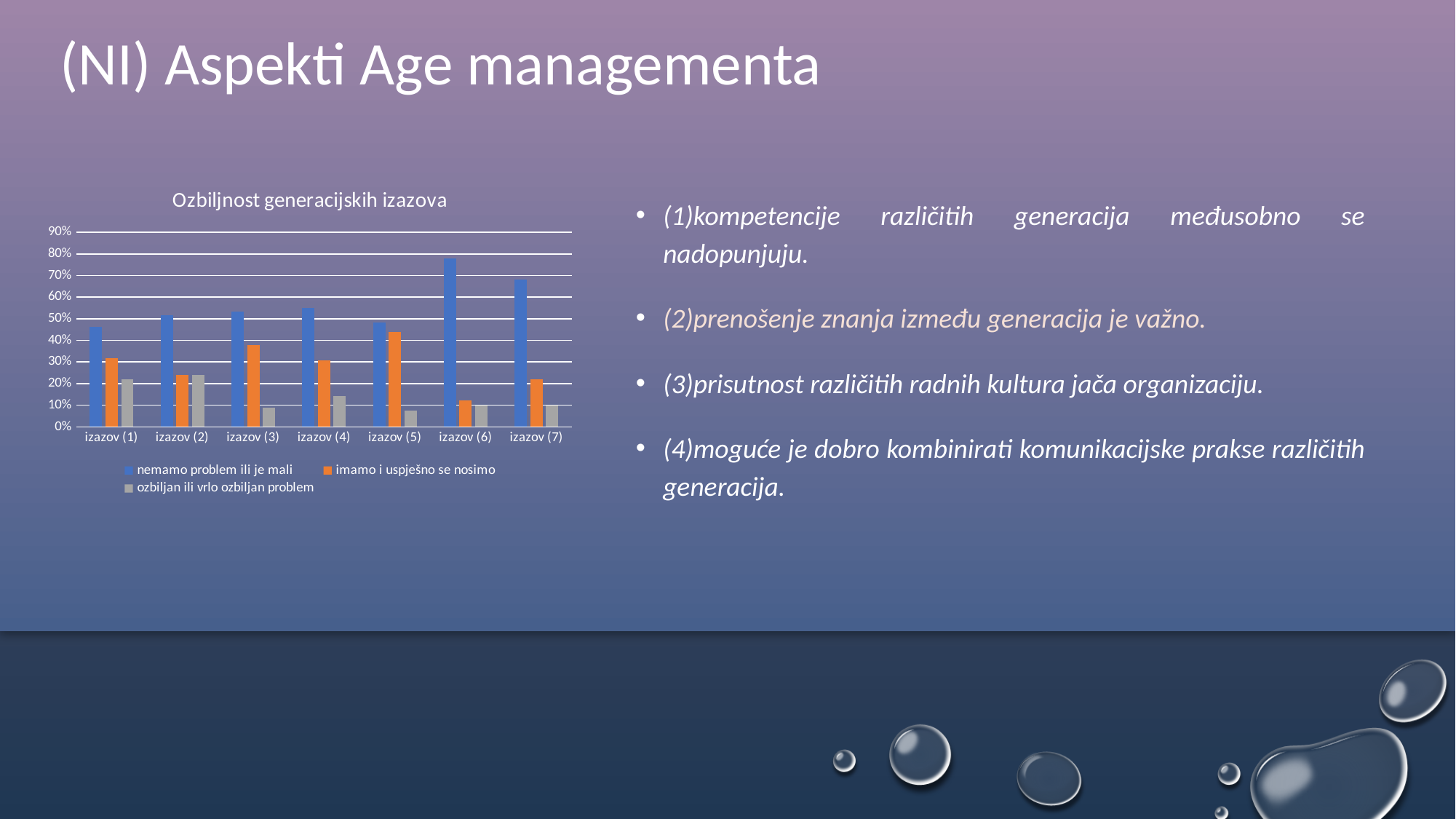
Is the 'nemamo problem ili je mali' value for izazov (6) greater or less than 70%? greater How many categories (izazovi) are shown on the x axis of the chart? 7 Which has the larger 'imamo i uspješno se nosimo' value, izazov (3) or izazov (4)? izazov (3) How many series does the chart legend list? 3 For which category is the 'imamo i uspješno se nosimo' bar the highest? izazov (5) What is the title of the chart? Ozbiljnost generacijskih izazova Which has the larger 'nemamo problem ili je mali' value, izazov (6) or izazov (7)? izazov (6) For which category is the 'imamo i uspješno se nosimo' bar the lowest? izazov (6) For which category is the 'nemamo problem ili je mali' bar the highest? izazov (6) What kind of chart is shown on the slide? bar chart Is the 'imamo i uspješno se nosimo' value for izazov (5) greater or less than 40%? greater